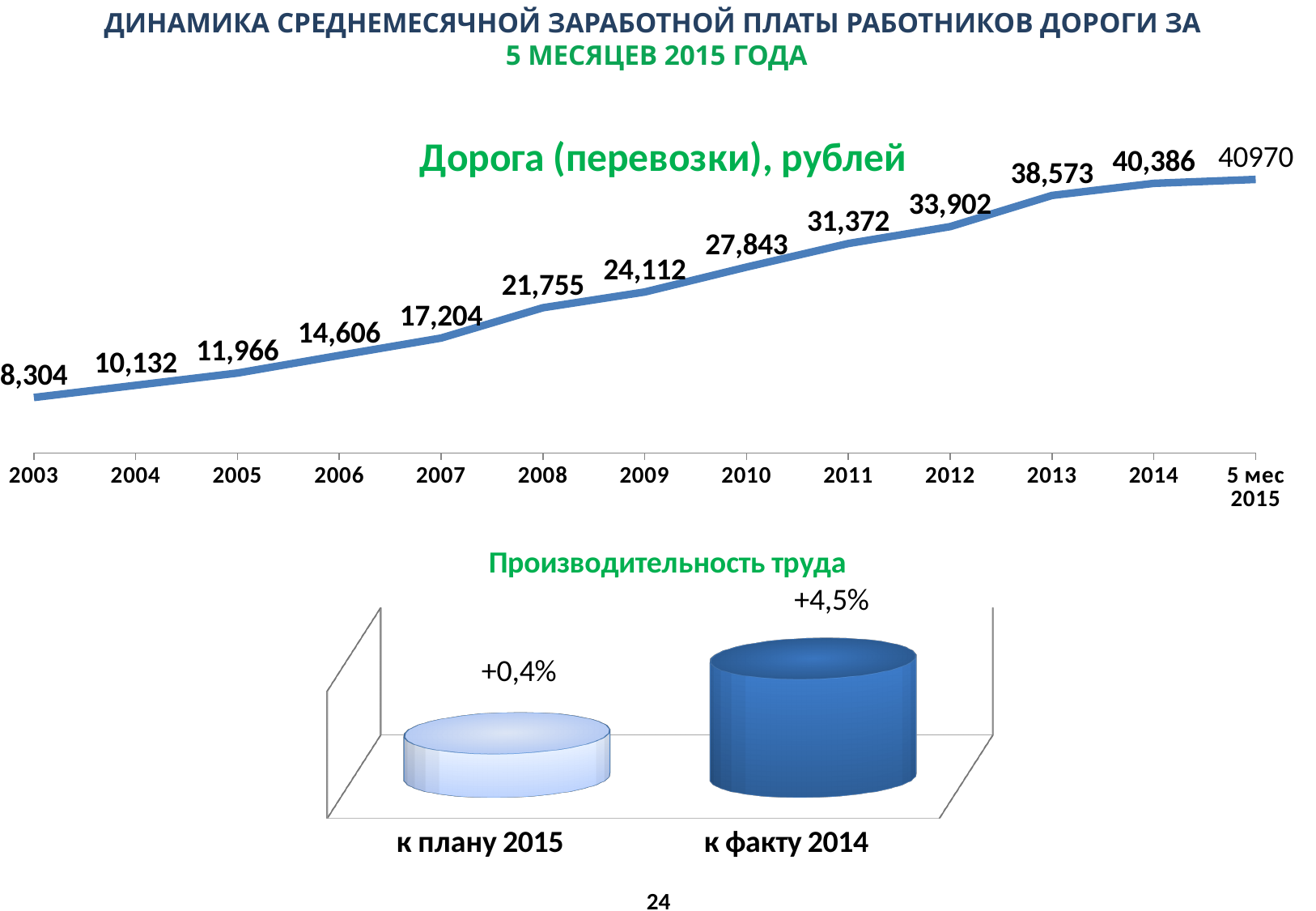
What kind of chart is the one titled "Производительность труда"? bar chart In the chart titled "Дорога (перевозки), рублей", what is the difference between the values for 2014 and 2013? 1,813 What kind of chart is the one titled "Дорога (перевозки), рублей"? line chart In the chart titled "Дорога (перевозки), рублей", what is the value for 2010? 27,843 In the chart titled "Дорога (перевозки), рублей", which point has the highest value? 5 мес 2015 In the chart titled "Производительность труда", which category has the larger value, "к плану 2015" or "к факту 2014"? к факту 2014 In the chart titled "Производительность труда", what is the value for "к факту 2014"? +4,5% In the chart titled "Дорога (перевозки), рублей", what is the value for "5 мес 2015"? 40970 In the chart titled "Дорога (перевозки), рублей", how many data points are plotted? 13 In the chart titled "Дорога (перевозки), рублей", do the values rise or fall from 2003 to 5 мес 2015? rise In the chart titled "Дорога (перевозки), рублей", which year has the lowest value? 2003 In the chart titled "Дорога (перевозки), рублей", what is the value for 2003? 8,304